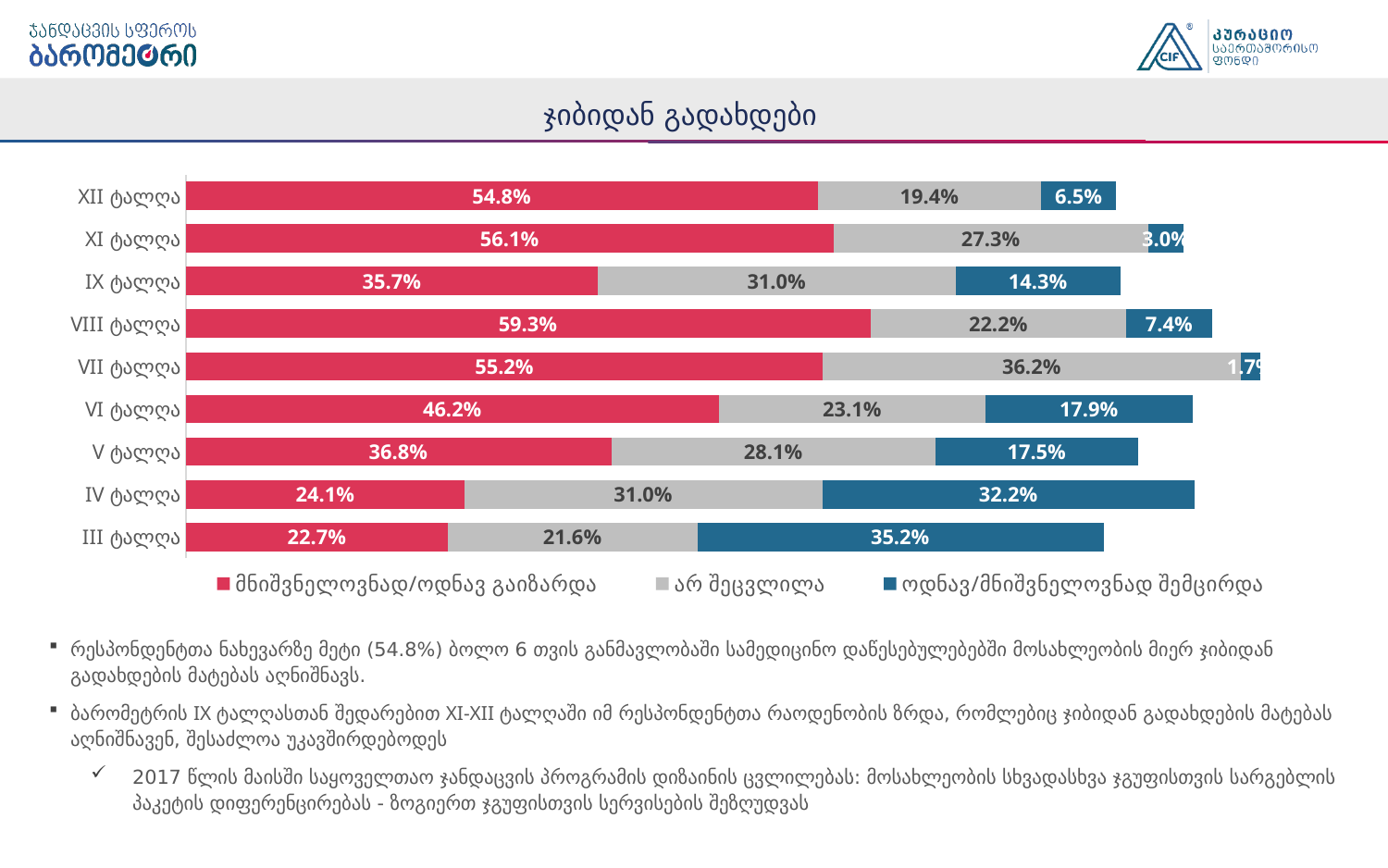
What is the value of the 'მნიშვნელოვნად/ოდნავ გაიზარდა' series for XII ტალღა? 54.8% Which category has the lowest value for the 'მნიშვნელოვნად/ოდნავ გაიზარდა' series? III ტალღა What is the value of the 'ოდნავ/მნიშვნელოვნად შემცირდა' series for IV ტალღა? 32.2% Which category has the highest value for the 'ოდნავ/მნიშვნელოვნად შემცირდა' series? III ტალღა What is the difference between the 'მნიშვნელოვნად/ოდნავ გაიზარდა' values for XI ტალღა and IX ტალღა? 20.4% How many series does the legend list? 3 What is the title of the chart? ჯიბიდან გადახდები Which is larger: the 'არ შეცვლილა' value for VI ტალღა or for V ტალღა? V ტალღა Which category has the highest value for the 'მნიშვნელოვნად/ოდნავ გაიზარდა' series? VIII ტალღა What kind of chart is shown on the slide? Stacked bar chart What is the value of the 'არ შეცვლილა' series for VII ტალღა? 36.2% How many categories (waves) are shown on the chart? 9